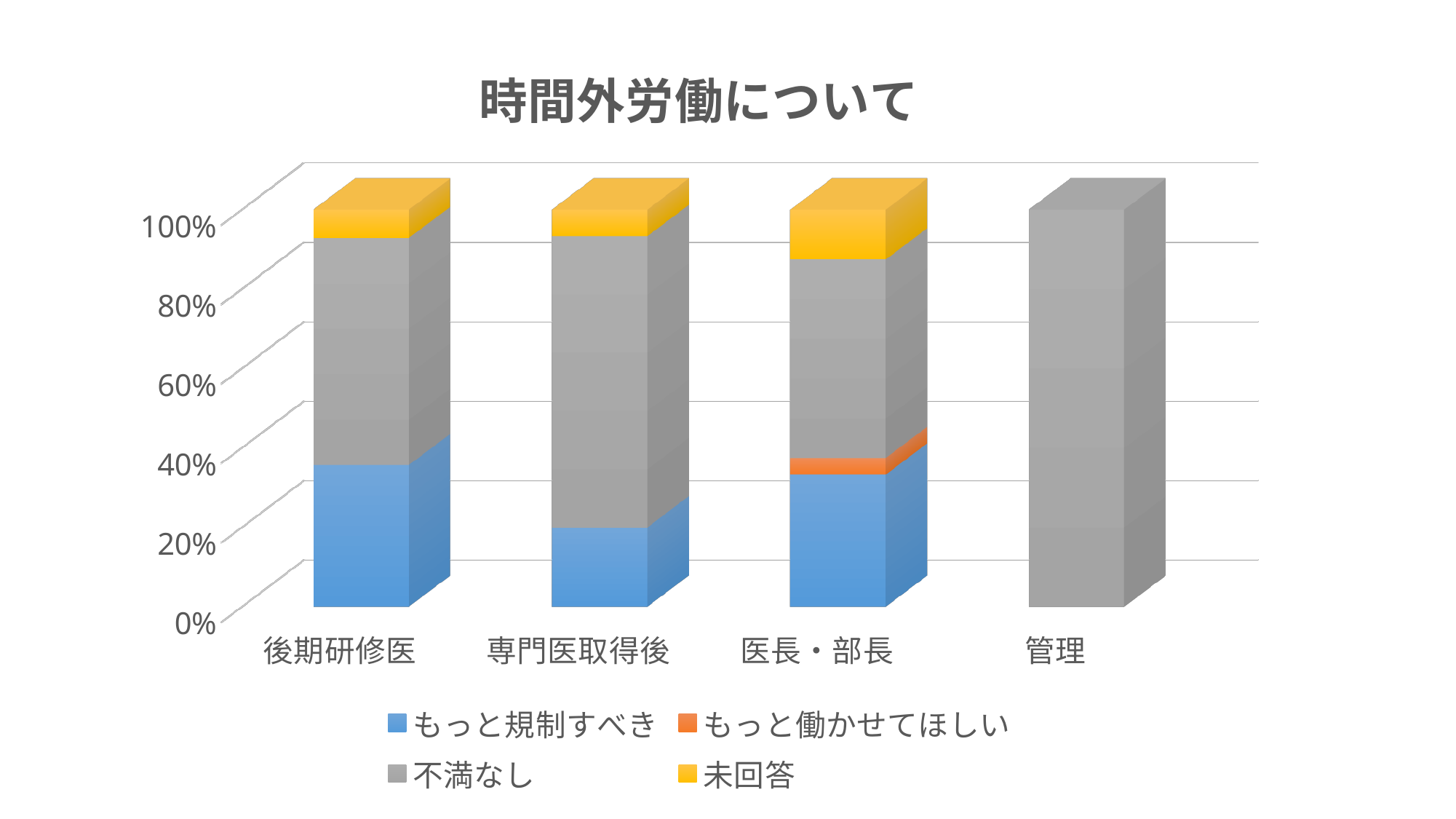
Which category has the largest 未回答 share? 医長・部長 Which has the larger もっと規制すべき share, 後期研修医 or 専門医取得後? 後期研修医 Is the もっと規制すべき share for 医長・部長 greater or less than 20%? greater Which has the larger 不満なし share, 専門医取得後 or 医長・部長? 専門医取得後 Which category is the only one with a もっと働かせてほしい segment? 医長・部長 What kind of chart is shown on the slide? Stacked bar chart What is the title of the chart? 時間外労働について How many categories are shown on the x axis? 4 How many series does the legend list? 4 Which category's bar consists entirely of 不満なし? 管理 Is the 不満なし share for 専門医取得後 greater or less than 60%? greater Is the もっと規制すべき share for 専門医取得後 greater or less than 40%? less